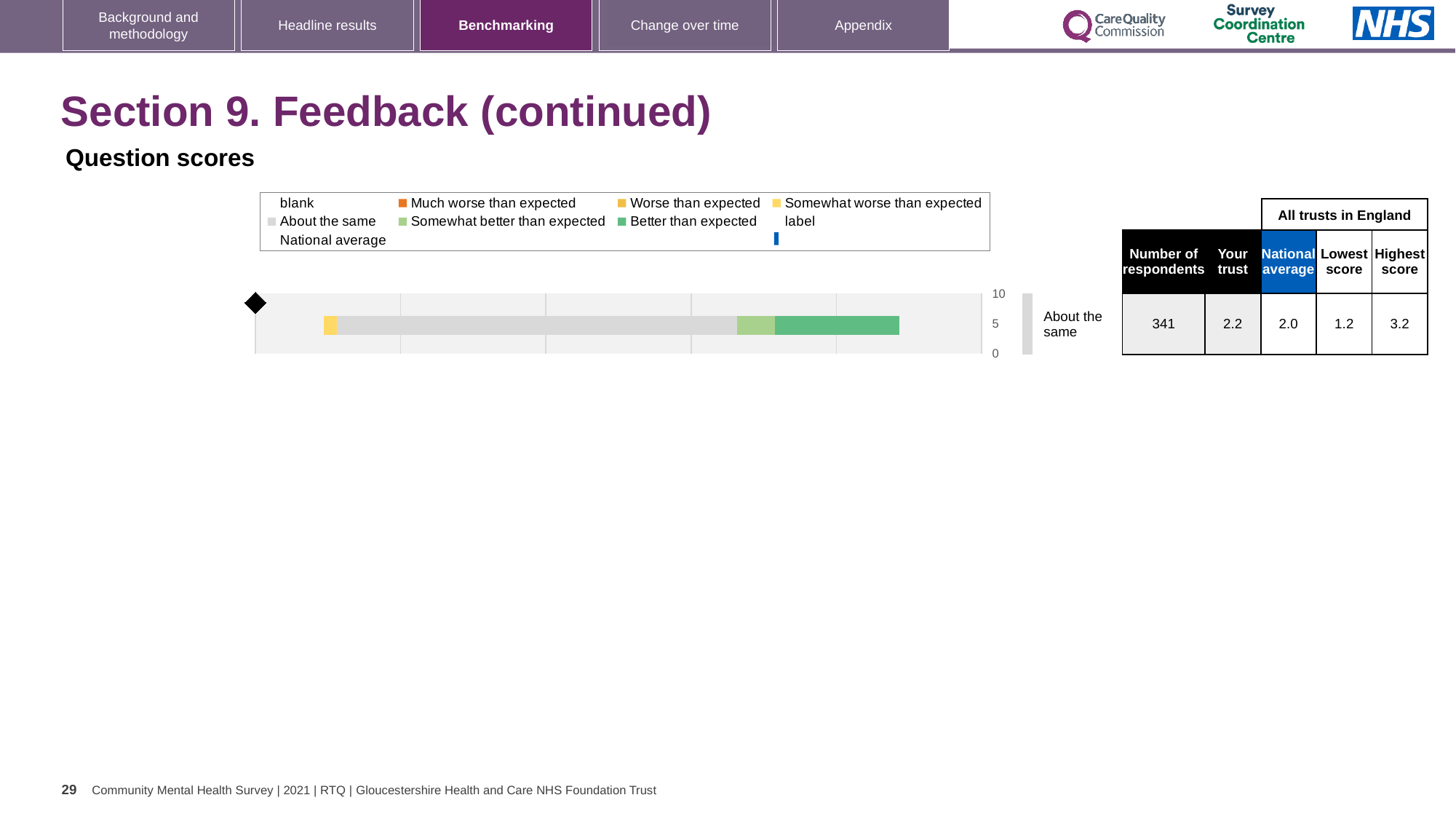
Which is larger for this question: the 'Your trust' score or the national average? Your trust How many respondents are shown for the question in the chart? 341 How many bars are plotted in the chart? 1 What is the 'Your trust' score shown for the question in the chart? 2.2 What kind of chart is shown on the slide? Bar chart What is the national average score shown for the question in the chart? 2.0 What is the highest score among all trusts in England shown for this question? 3.2 What benchmark category label is shown next to the bar in the chart? About the same What is the difference between the highest score and the lowest score shown for this question? 2.0 What is the lowest score among all trusts in England shown for this question? 1.2 What colour represents 'Better than expected' in the chart legend? Green